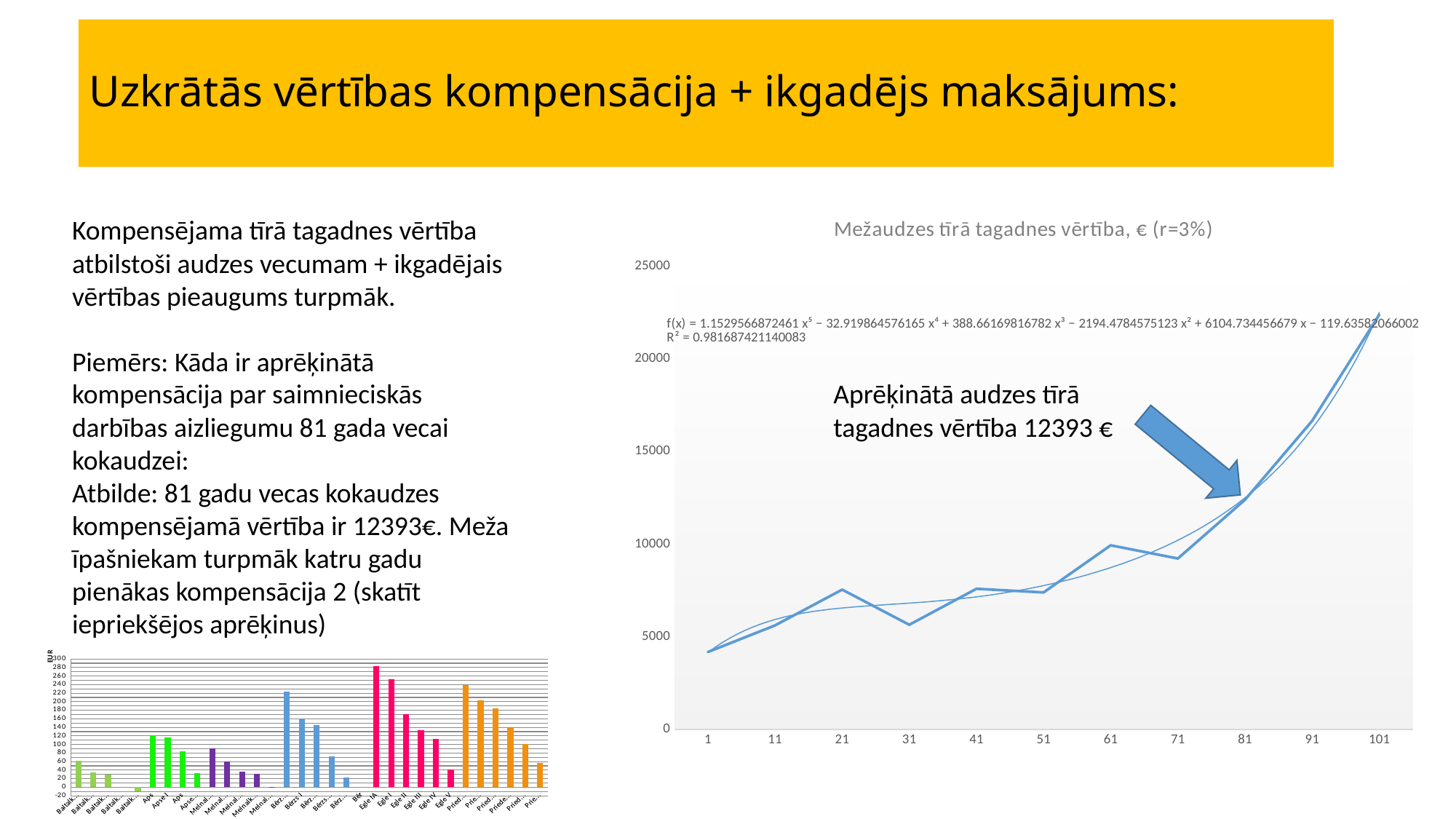
In the chart "Mežaudzes tīrā tagadnes vērtība, € (r=3%)", at which x-axis value is the plotted value highest? 101 In the chart "Mežaudzes tīrā tagadnes vērtība, € (r=3%)", what is the calculated net present value at age 81 as annotated on the slide? 12393 € In the chart "Mežaudzes tīrā tagadnes vērtība, € (r=3%)", is the value at x = 71 greater or less than 10000? less In the chart "Mežaudzes tīrā tagadnes vērtība, € (r=3%)", which has the larger value: x = 21 or x = 31? 21 In the chart "Mežaudzes tīrā tagadnes vērtība, € (r=3%)", at which x-axis value is the plotted value lowest? 1 In the chart "Mežaudzes tīrā tagadnes vērtība, € (r=3%)", do the values generally rise or fall as x increases from 1 to 101? rise What kind of chart is the chart titled "Mežaudzes tīrā tagadnes vērtība, € (r=3%)"? line chart What kind of chart is the small chart at the bottom left of the slide? bar chart In the chart "Mežaudzes tīrā tagadnes vērtība, € (r=3%)", is the value at x = 101 greater or less than 20000? greater What is the title of the line chart on the right side of the slide? Mežaudzes tīrā tagadnes vērtība, € (r=3%) In the chart "Mežaudzes tīrā tagadnes vērtība, € (r=3%)", is the value at x = 1 greater or less than 5000? less What is the R² value printed on the chart "Mežaudzes tīrā tagadnes vērtība, € (r=3%)"? 0.981687421140083